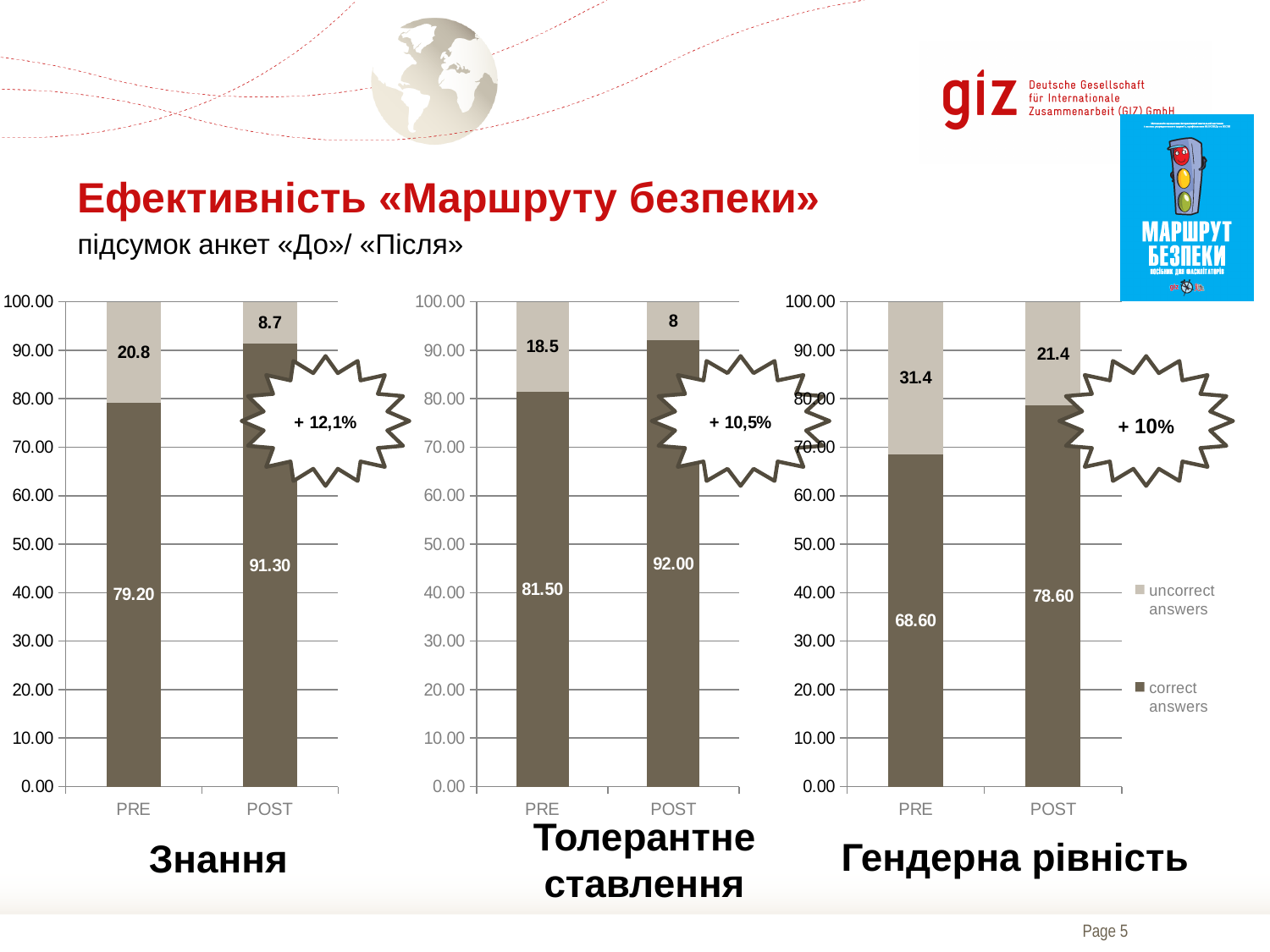
In the left chart (Знання), what is the difference between the correct answers values for POST and PRE? 12.1 In the left chart (Знання), what is the value of uncorrect answers for POST? 8.7 How many series does the legend on the right chart (Гендерна рівність) list? 2 In the middle chart (Толерантне ставлення), what is the value of correct answers for POST? 92.00 In the middle chart (Толерантне ставлення), is the correct answers value for PRE greater or less than 80.00? greater In the middle chart (Толерантне ставлення), what is the value of uncorrect answers for PRE? 18.5 In the right chart (Гендерна рівність), what is the total of the stacked bar for PRE? 100.00 In the right chart (Гендерна рівність), which category has the larger correct answers value, PRE or POST? POST In the right chart (Гендерна рівність), what is the value of uncorrect answers for POST? 21.4 In the left chart (Знання), what is the value of correct answers for PRE? 79.20 In the right chart (Гендерна рівність), what is the value of correct answers for PRE? 68.60 What kind of chart is the left chart (Знання)? stacked bar chart